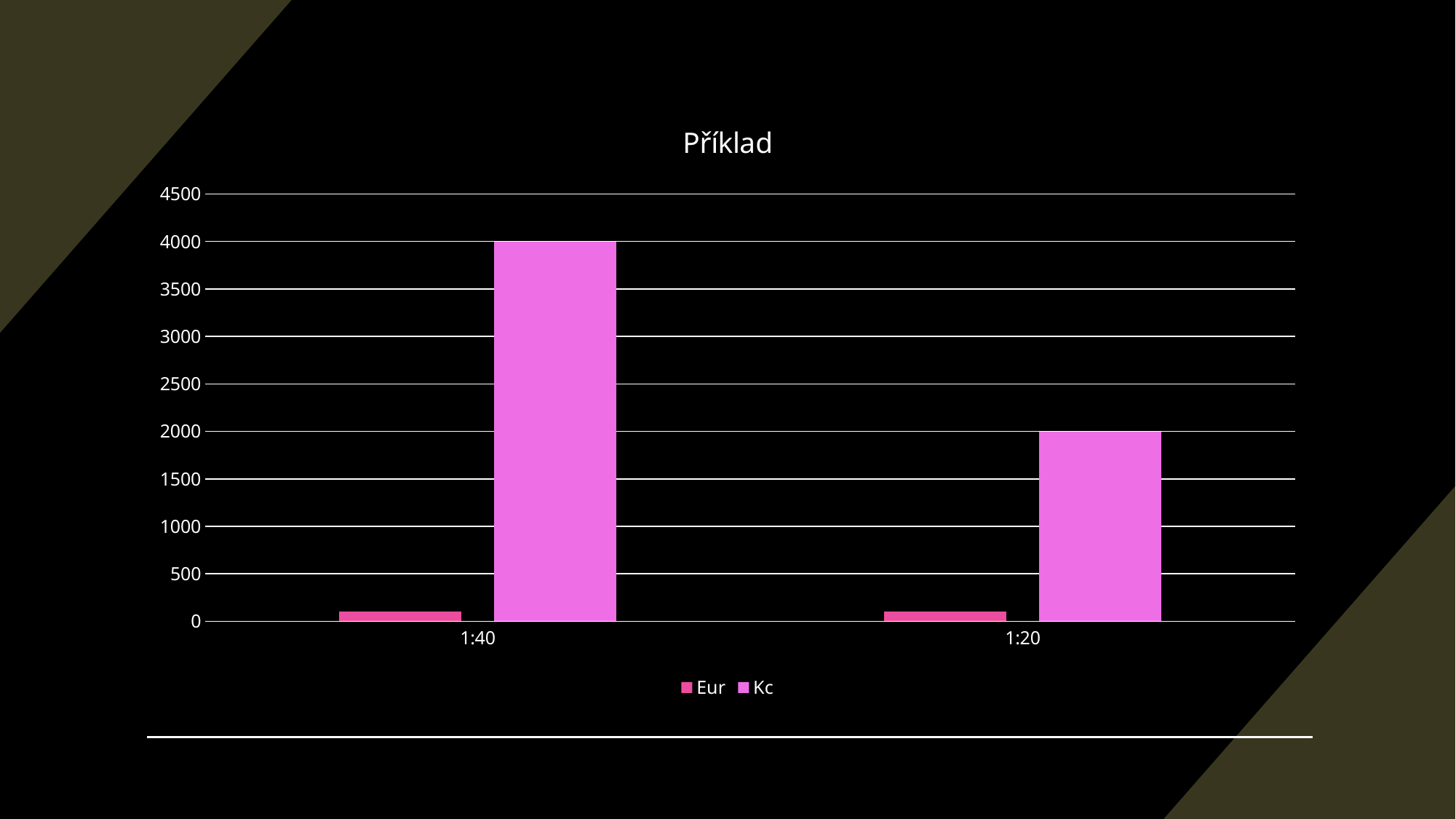
Which category has the higher Kc value? 1:40 Does the Kc value rise or fall from 1:40 to 1:20? fall What is the title of the chart? Příklad How many categories are shown on the x axis? 2 Is the Eur value for 1:20 greater or less than 500? less What is the Kc value for 1:40? 4000 For 1:20, which series has the larger value, Eur or Kc? Kc How many series does the legend list? 2 Is the Eur value for 1:40 greater or less than 500? less What type of chart is shown on the slide? bar chart What is the Kc value for 1:20? 2000 What is the difference between the Kc value for 1:40 and the Kc value for 1:20? 2000